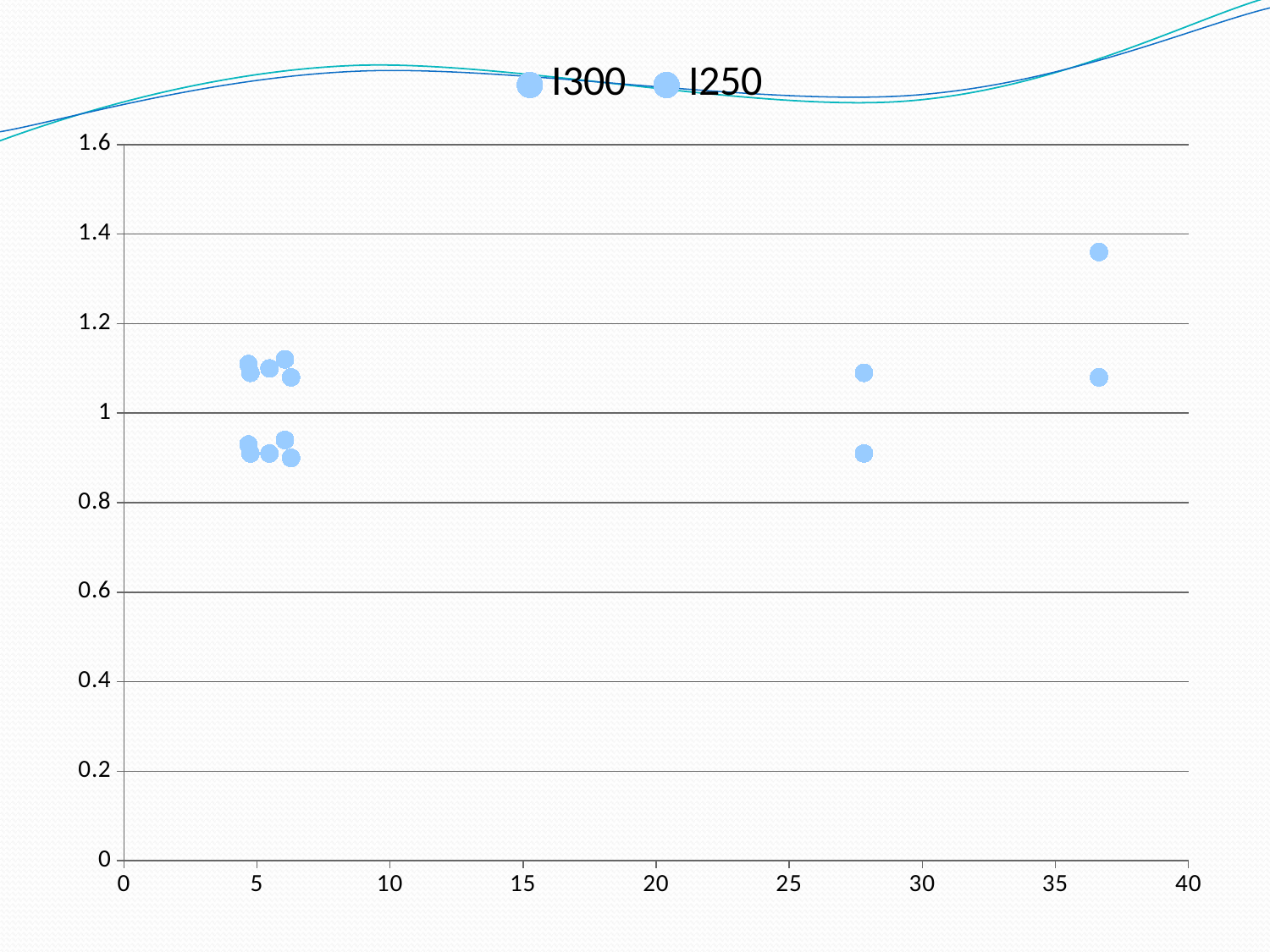
Is the upper point near x = 28 greater or less than 1? greater Is the highest plotted point (near x = 37) greater or less than 1.2? greater How many series does the legend list? 2 Is the lower point near x = 37 greater or less than 1.2? less What is the maximum value shown on the vertical axis? 1.6 Which is larger: the upper point near x = 37 or the upper point near x = 28? the upper point near x = 37 What are the two series names shown in the legend? I300 and I250 What kind of chart is shown on the slide? scatter chart